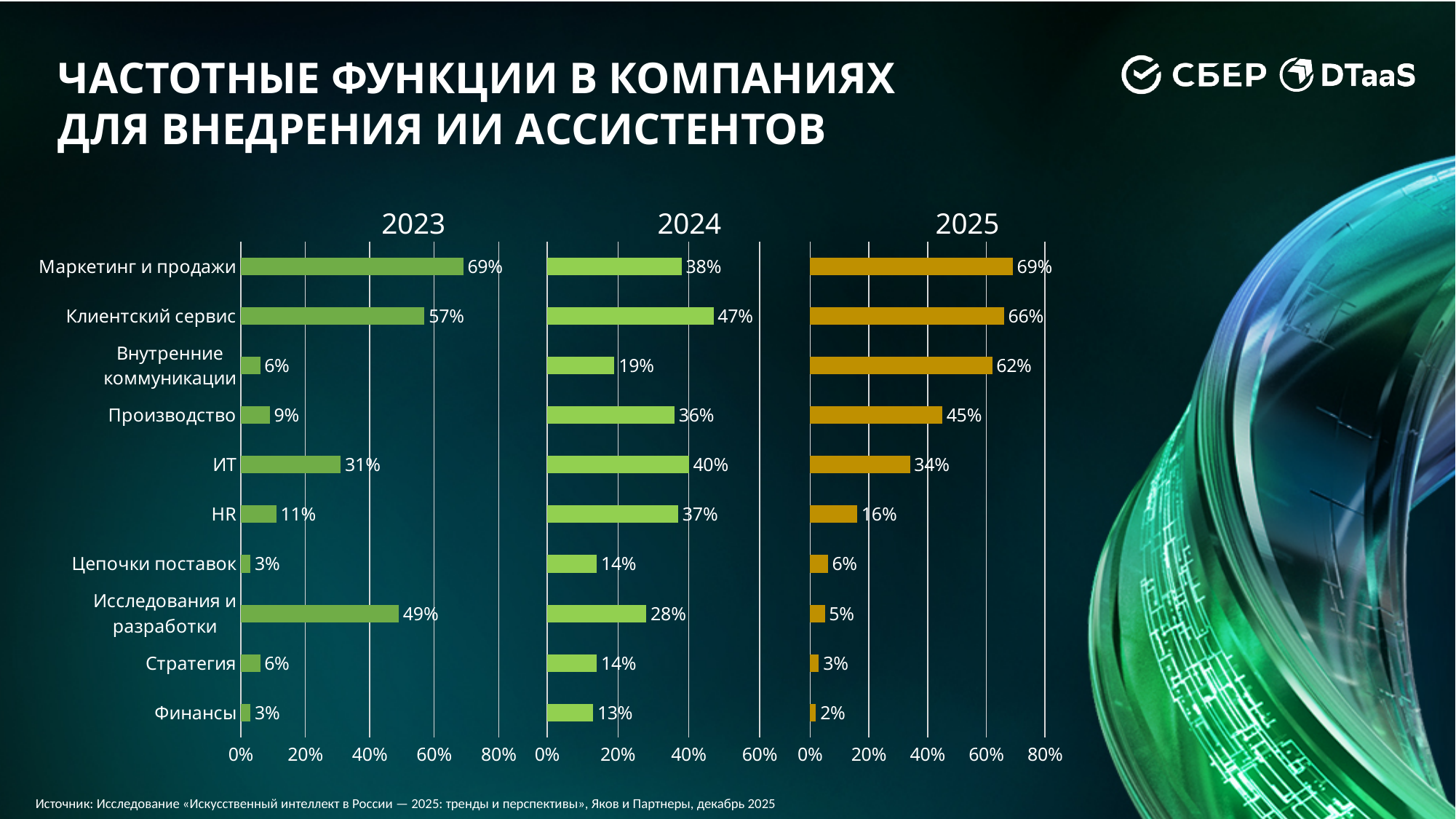
How many charts are shown on the slide? 3 In the 2024 chart, what is the value for Клиентский сервис? 47% In the 2024 chart, which category has the highest value? Клиентский сервис In the 2025 chart, which category has the lowest value? Финансы How many categories are shown in the 2023 chart? 10 What kind of chart is used for the 2025 data? Bar chart What is the value for Исследования и разработки in the 2025 chart? 5% In the 2025 chart, what is the value for Внутренние коммуникации? 62% In the 2023 chart, what is the value for Маркетинг и продажи? 69% In the 2023 chart, what is the difference between Маркетинг и продажи and Клиентский сервис? 12% In the 2024 chart, is the value for ИТ greater or less than 20%? greater In the 2025 chart, which is larger: the value for ИТ or the value for Производство? Производство